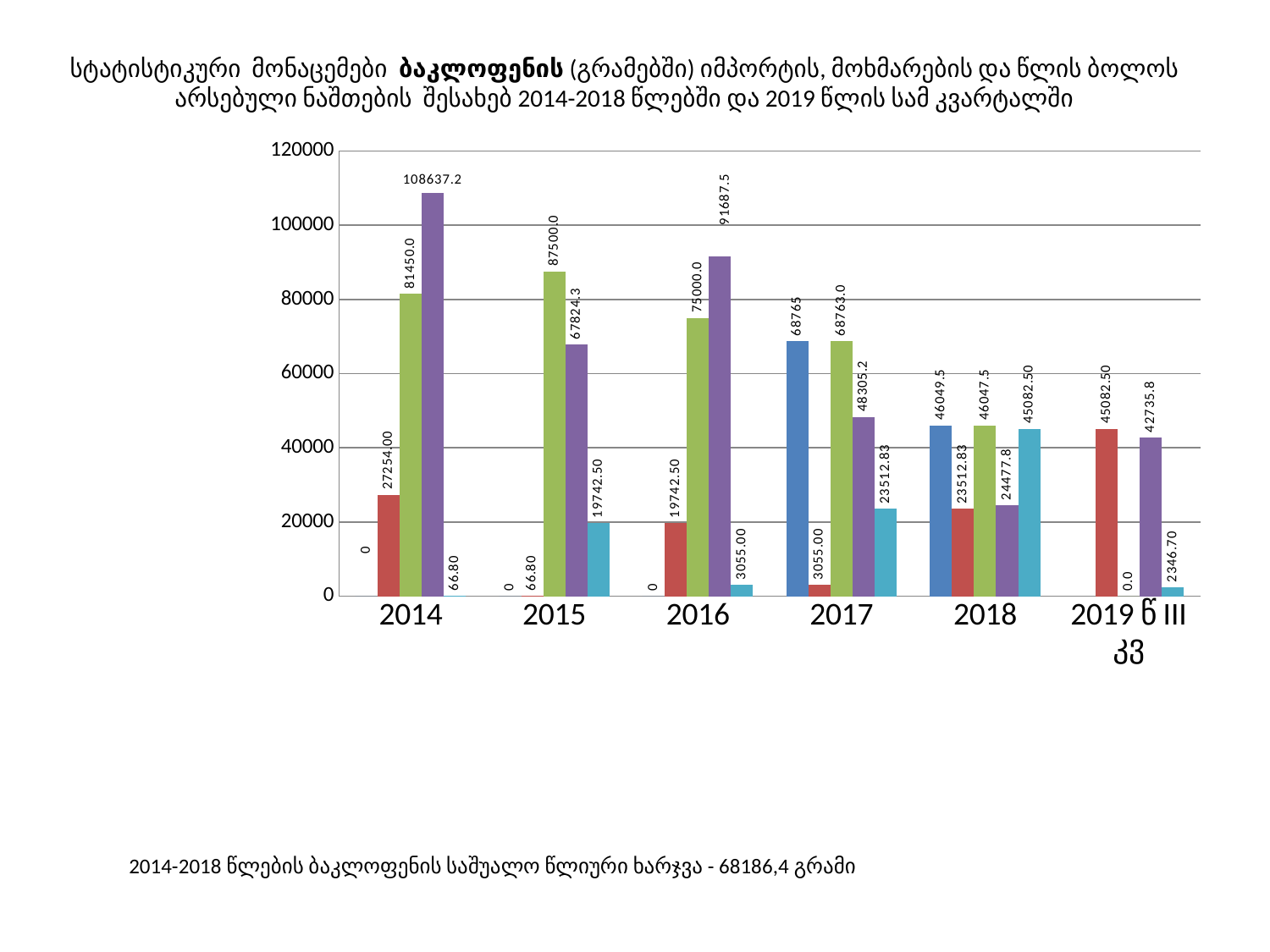
What is the value of the blue bar for 2017? 68765 Which is larger: the green bar for 2016 or the purple bar for 2016? the purple bar (91687.5) What is the value of the cyan bar for 2019 წ III კვ? 2346.70 What is the value of the green bar for 2015? 87500.0 Is the value of the red bar for 2014 greater or less than 20000? greater What is the value of the purple bar for 2014? 108637.2 How many categories are shown along the x axis of the chart? 6 Does the purple bar rise or fall from 2016 to 2018? fall What kind of chart is shown on the slide? bar chart In which year does the purple bar reach its highest value? 2014 In which year is the green bar lowest among 2014 to 2018? 2018 What is the difference between the purple bar for 2016 (91687.5) and the purple bar for 2017 (48305.2)? 43382.3